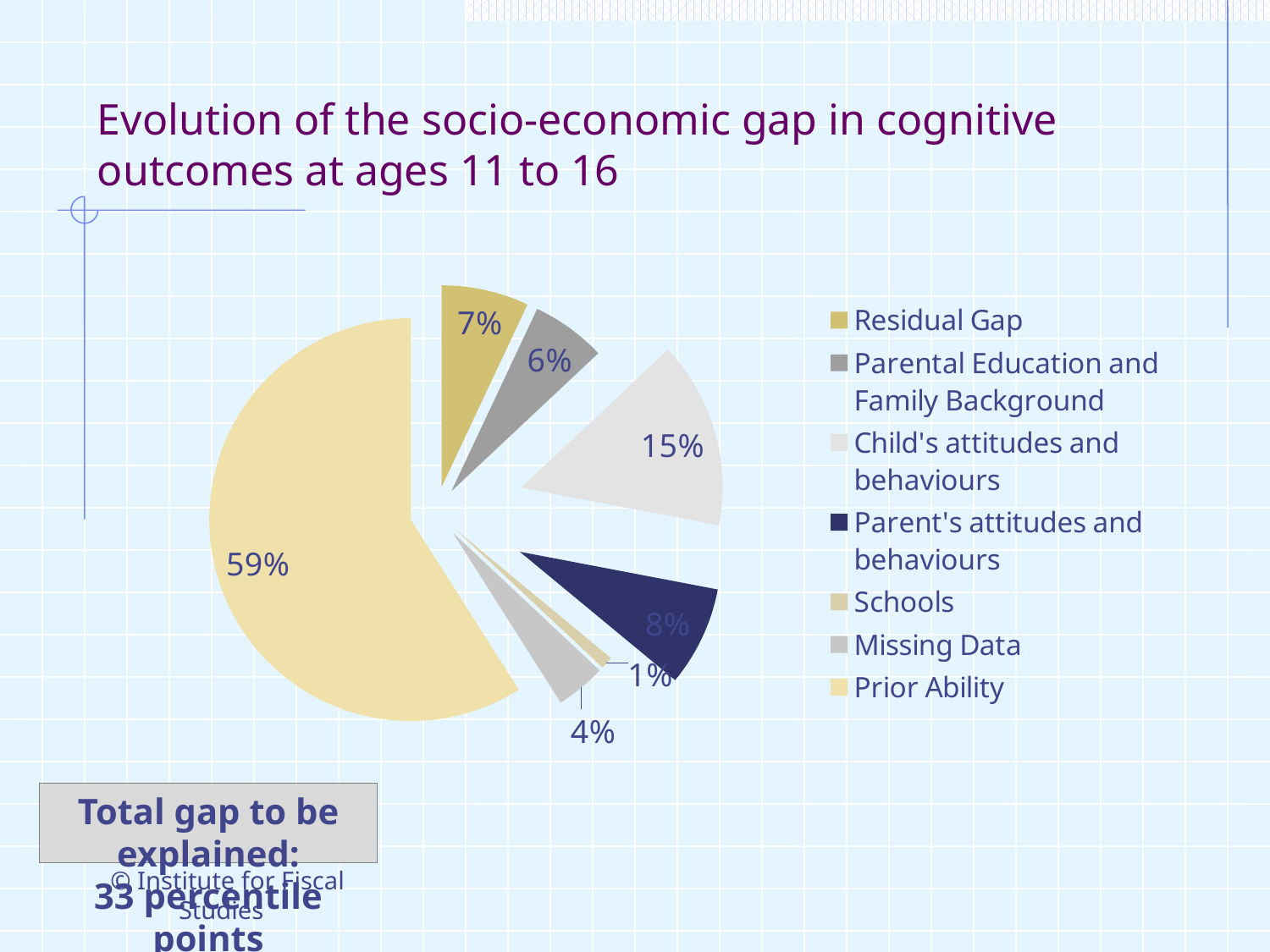
What is the value shown for Parental Education and Family Background? 6% What share of the pie does Child's attitudes and behaviours account for? 15% Which category has the largest slice of the pie? Prior Ability Which is larger, the Parent's attitudes and behaviours slice or the Residual Gap slice? Parent's attitudes and behaviours What kind of chart is shown on the slide? pie chart What is the difference between the Child's attitudes and behaviours slice and the Missing Data slice? 11% How many categories does the legend list? 7 Which category has the smallest slice of the pie? Schools What is the value shown for Residual Gap? 7% What is the value shown for Parent's attitudes and behaviours? 8% What is the value shown for Schools? 1% What share of the pie does Prior Ability account for? 59%